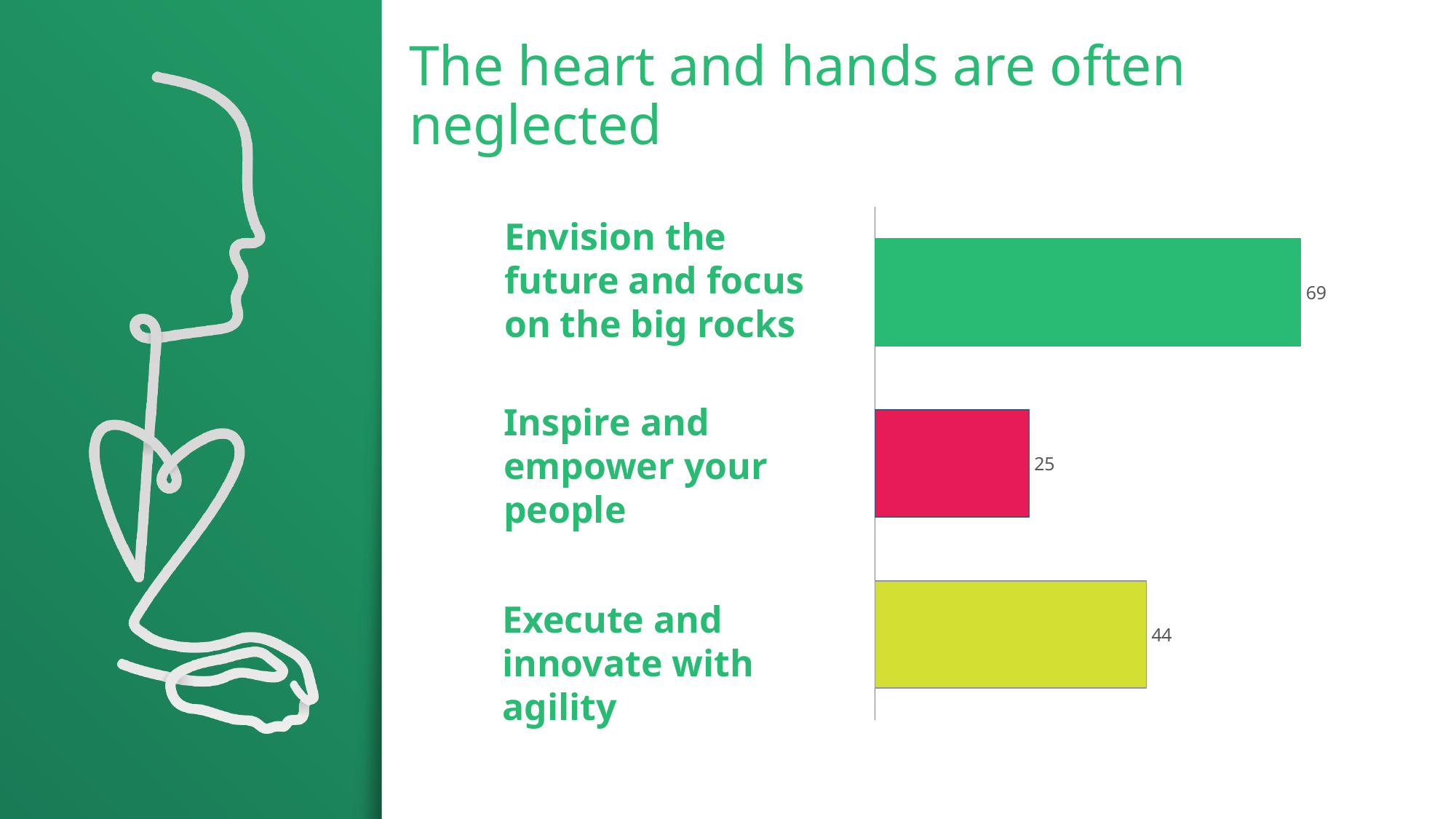
What is the value for "Envision the future and focus on the big rocks"? 69 What is the difference between the values for "Envision the future and focus on the big rocks" and "Inspire and empower your people"? 44 Which is larger, the value for "Execute and innovate with agility" or the value for "Inspire and empower your people"? Execute and innovate with agility What is the difference between the values for "Execute and innovate with agility" and "Inspire and empower your people"? 19 What is the value for "Execute and innovate with agility"? 44 What kind of chart is shown on the slide? Bar chart How many categories are shown in the chart? 3 What is the total of the three values shown in the chart? 138 Which category has the lowest value? Inspire and empower your people What colour is the bar for "Inspire and empower your people"? Red Which category has the highest value? Envision the future and focus on the big rocks What is the value for "Inspire and empower your people"? 25